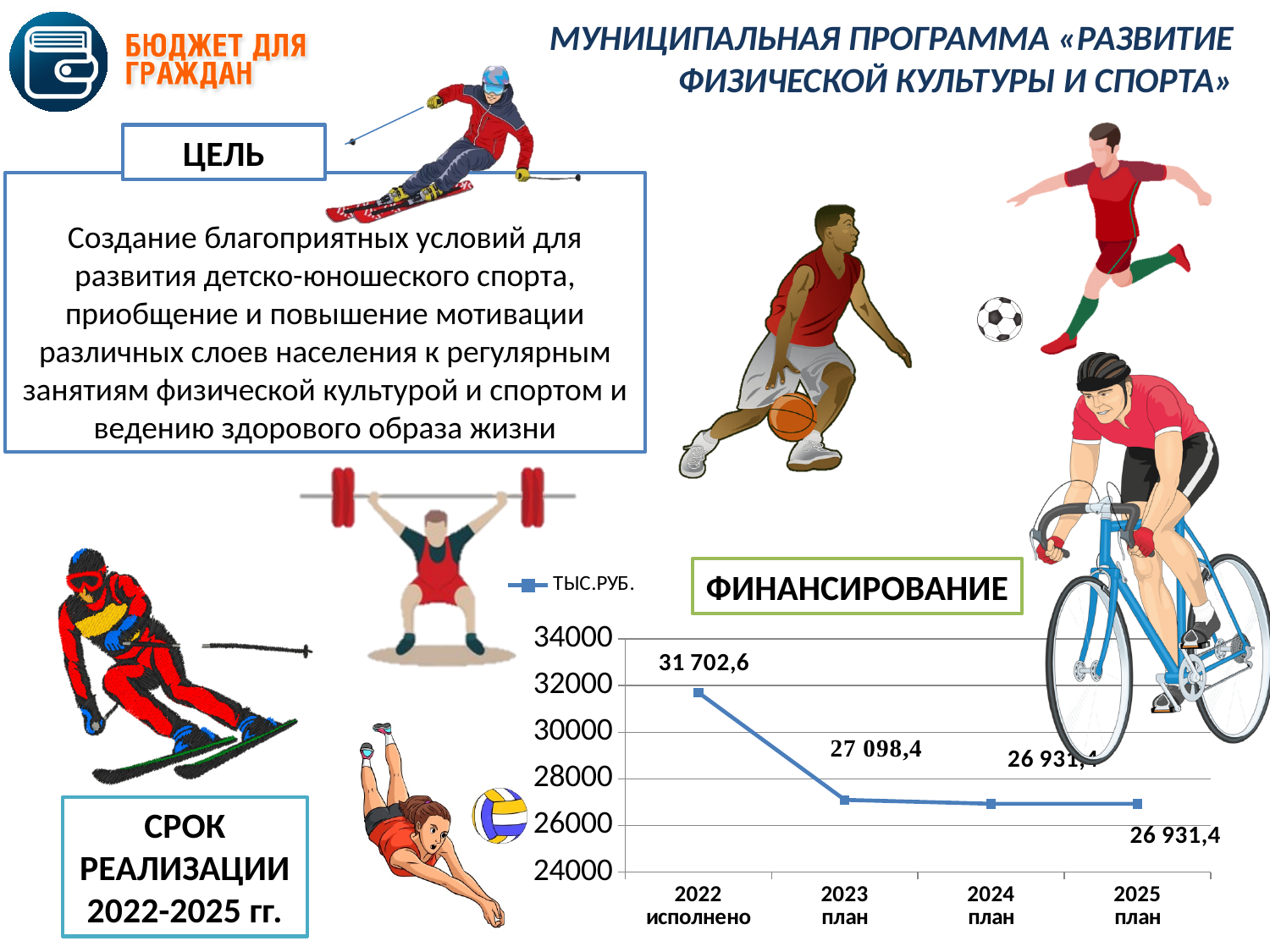
What is the value for 2025 план on the ФИНАНСИРОВАНИЕ chart? 26 931,4 On the ФИНАНСИРОВАНИЕ chart, is the value for 2024 план greater or less than 28000? less How many series does the legend of the ФИНАНСИРОВАНИЕ chart list? 1 On the ФИНАНСИРОВАНИЕ chart, which is larger: the value for 2022 исполнено or for 2023 план? 2022 исполнено How many data points are plotted on the ФИНАНСИРОВАНИЕ chart? 4 What is the value for 2023 план on the ФИНАНСИРОВАНИЕ chart? 27 098,4 What kind of chart is shown under the heading ФИНАНСИРОВАНИЕ? line chart Do the values on the ФИНАНСИРОВАНИЕ chart rise or fall from 2022 to 2025? fall What is the value for 2022 исполнено on the ФИНАНСИРОВАНИЕ chart? 31 702,6 What is the difference between the values for 2022 исполнено and 2023 план on the ФИНАНСИРОВАНИЕ chart? 4 604,2 What is the difference between the values for 2023 план and 2025 план on the ФИНАНСИРОВАНИЕ chart? 167,0 Which year has the highest value on the ФИНАНСИРОВАНИЕ chart? 2022 исполнено